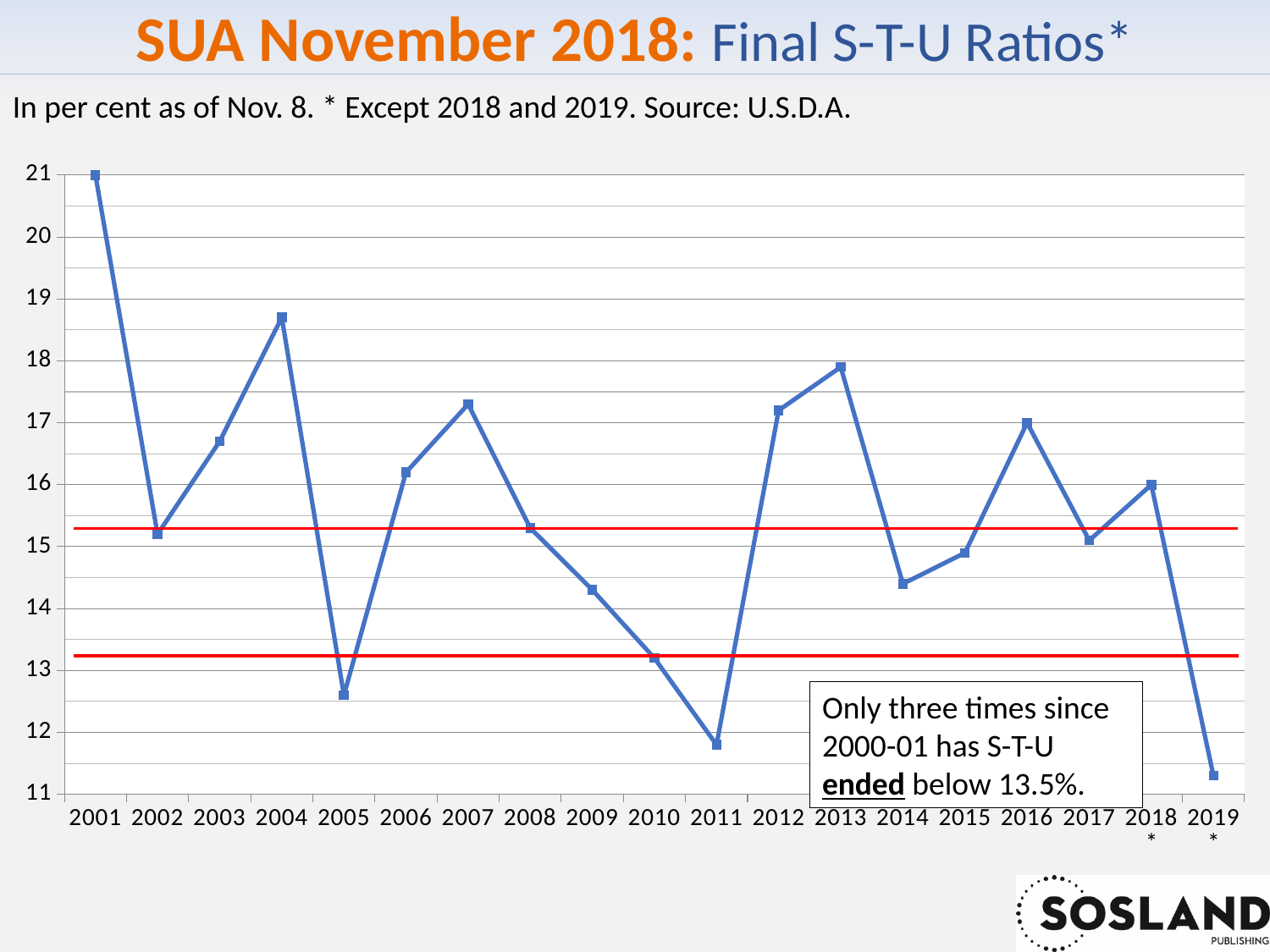
Is the value for 2011 greater or less than 12? less What kind of chart is shown on the slide? line chart Which year has the lowest S-T-U ratio? 2019 Is the value for 2005 greater or less than 13? less How many years are plotted along the x axis? 19 Is the value for 2004 greater or less than 18? greater Which year has the highest S-T-U ratio? 2001 Does the value rise or fall from 2001 to 2002? fall What is the S-T-U ratio for 2001? 21 According to the text box on the chart, how many times since 2000-01 has S-T-U ended below 13.5%? three Which year has the larger value, 2004 or 2007? 2004